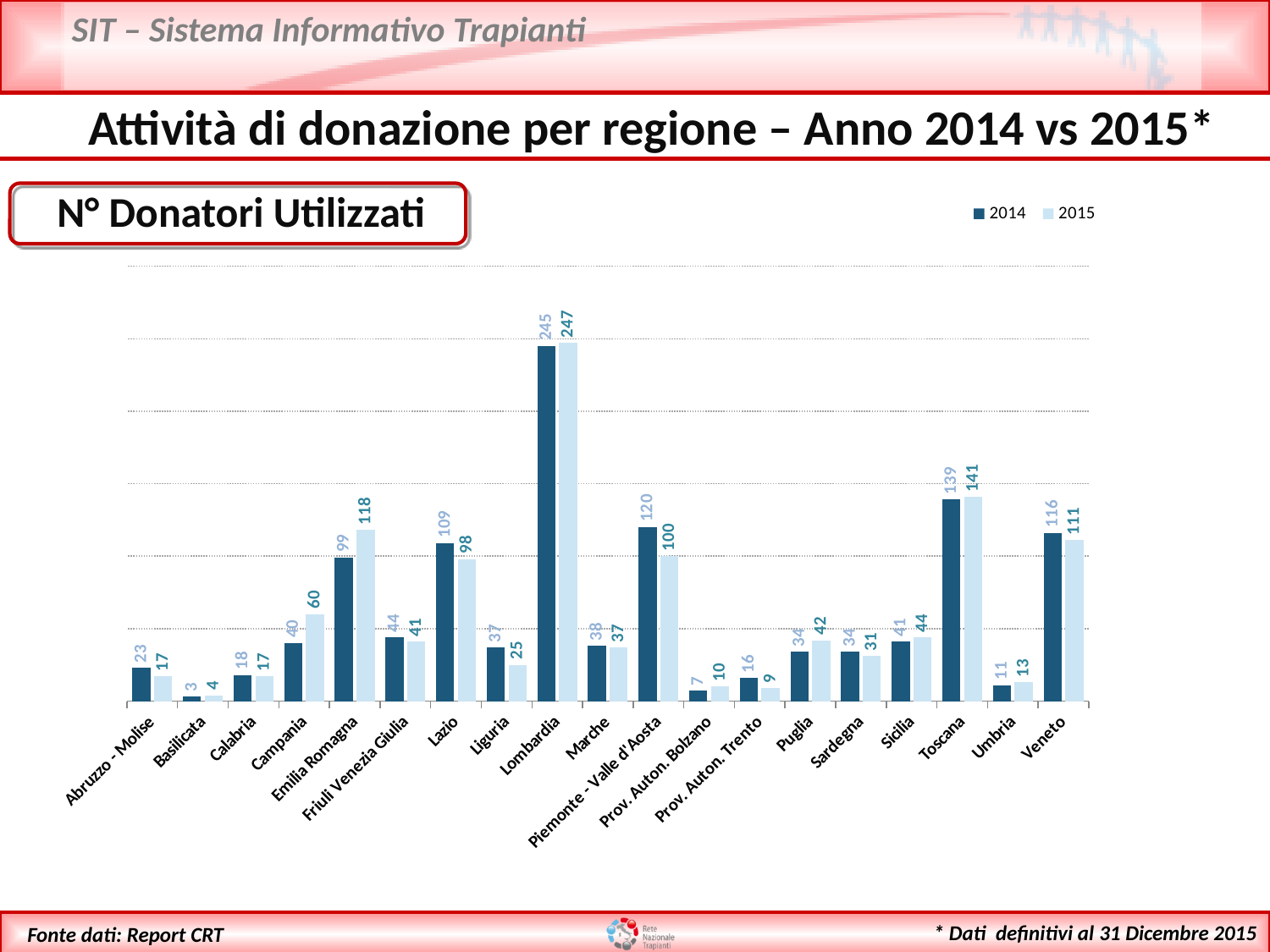
Which is larger, the 2015 value for Puglia or the 2015 value for Sardegna? Puglia Which is larger for Liguria, the 2014 value or the 2015 value? 2014 Which region has the highest 2015 value? Lombardia What is the 2014 value for Piemonte - Valle d'Aosta? 120 How many regions are shown on the x axis? 19 What is the difference between the 2014 and 2015 values for Lazio? 11 What is the 2015 value for Campania? 60 What kind of chart is shown on the slide? Bar chart What is the difference between the 2015 values for Toscana and Veneto? 30 What is the 2015 value for Emilia Romagna? 118 How many series does the legend list? 2 Which region has the lowest 2014 value? Basilicata